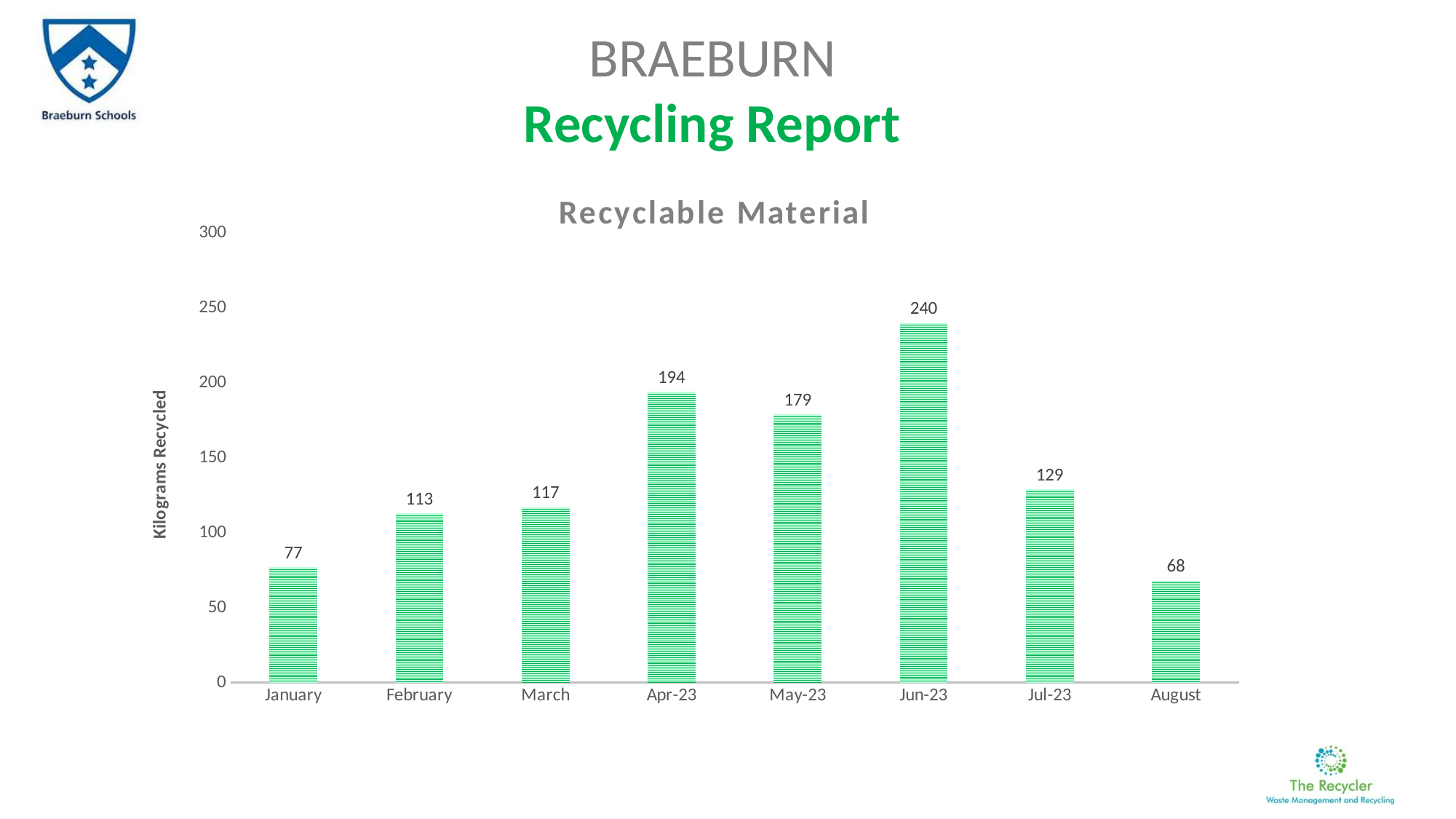
What is the difference between the values for March and February? 4 Which is larger, the value for Apr-23 or the value for May-23? Apr-23 What is the value shown for Apr-23? 194 What kind of chart is the Recyclable Material chart? bar chart Which month has the lowest value in the Recyclable Material chart? August Which month has the highest value in the Recyclable Material chart? Jun-23 How many kilograms were recycled in January? 77 What is the value for Jun-23 in the Recyclable Material chart? 240 What is the difference between the values for Jun-23 and Jul-23? 111 Is the value for Jul-23 greater or less than 100? greater How many months are shown on the x axis of the Recyclable Material chart? 8 What is the label on the vertical axis of the chart? Kilograms Recycled